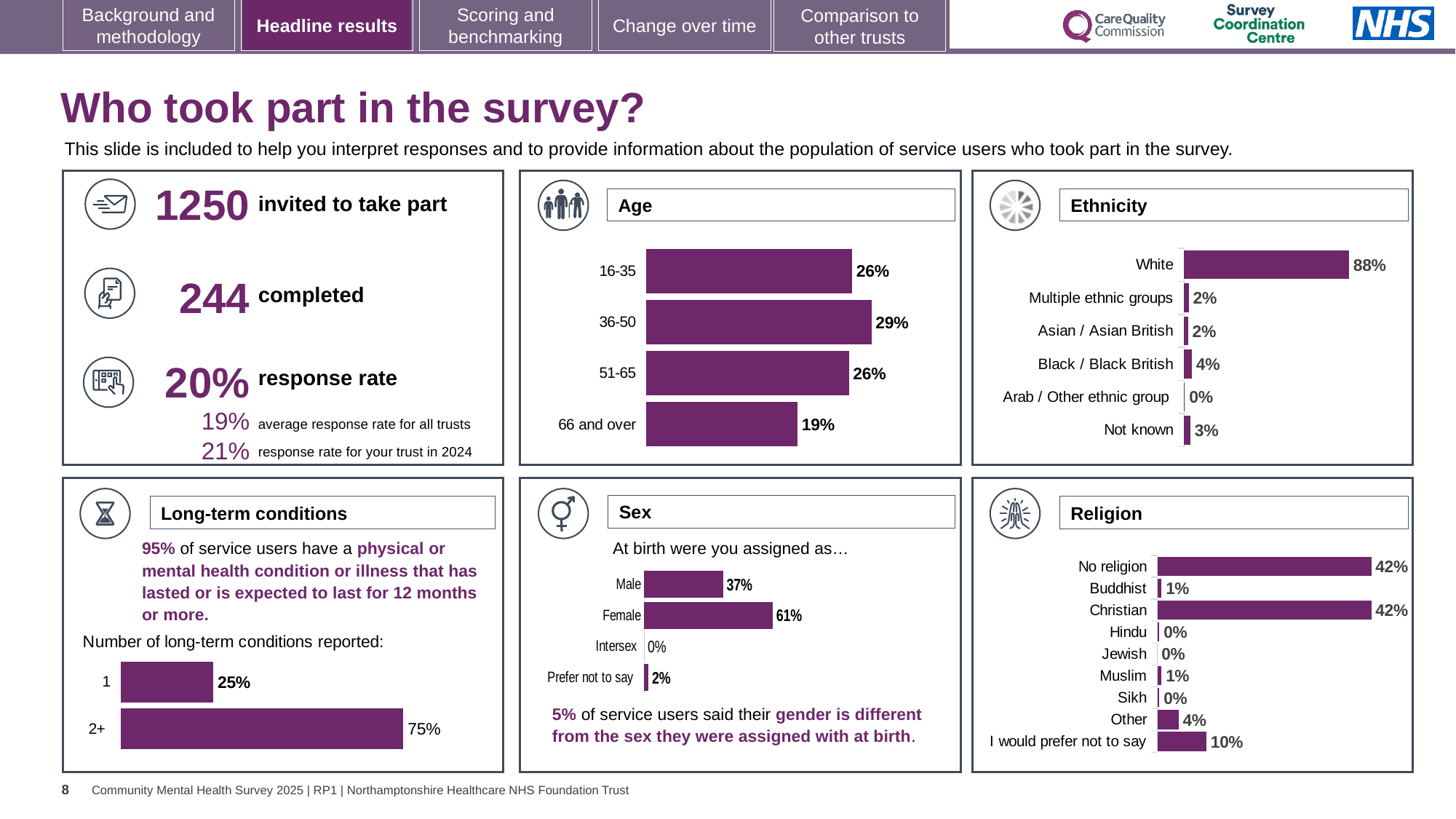
In the Religion chart, what percentage of respondents said they would prefer not to say? 10% In the Ethnicity chart, what is the difference between the White and Black / Black British percentages? 84% In the Age chart, which age group has the lowest percentage? 66 and over In the Age chart, what percentage of respondents were aged 36-50? 29% In the Long-term conditions chart, what percentage of service users reported 2+ long-term conditions? 75% In the Religion chart, how many religion categories are listed? 9 In the Sex chart, what percentage of respondents were assigned Female at birth? 61% In the Sex chart, which is larger, the Male or Female percentage? Female In the Ethnicity chart, which category has the highest percentage? White In the Age chart, how many age categories are shown? 4 What type of chart is used in the Age panel? Bar chart In the Ethnicity chart, what percentage of respondents were White? 88%